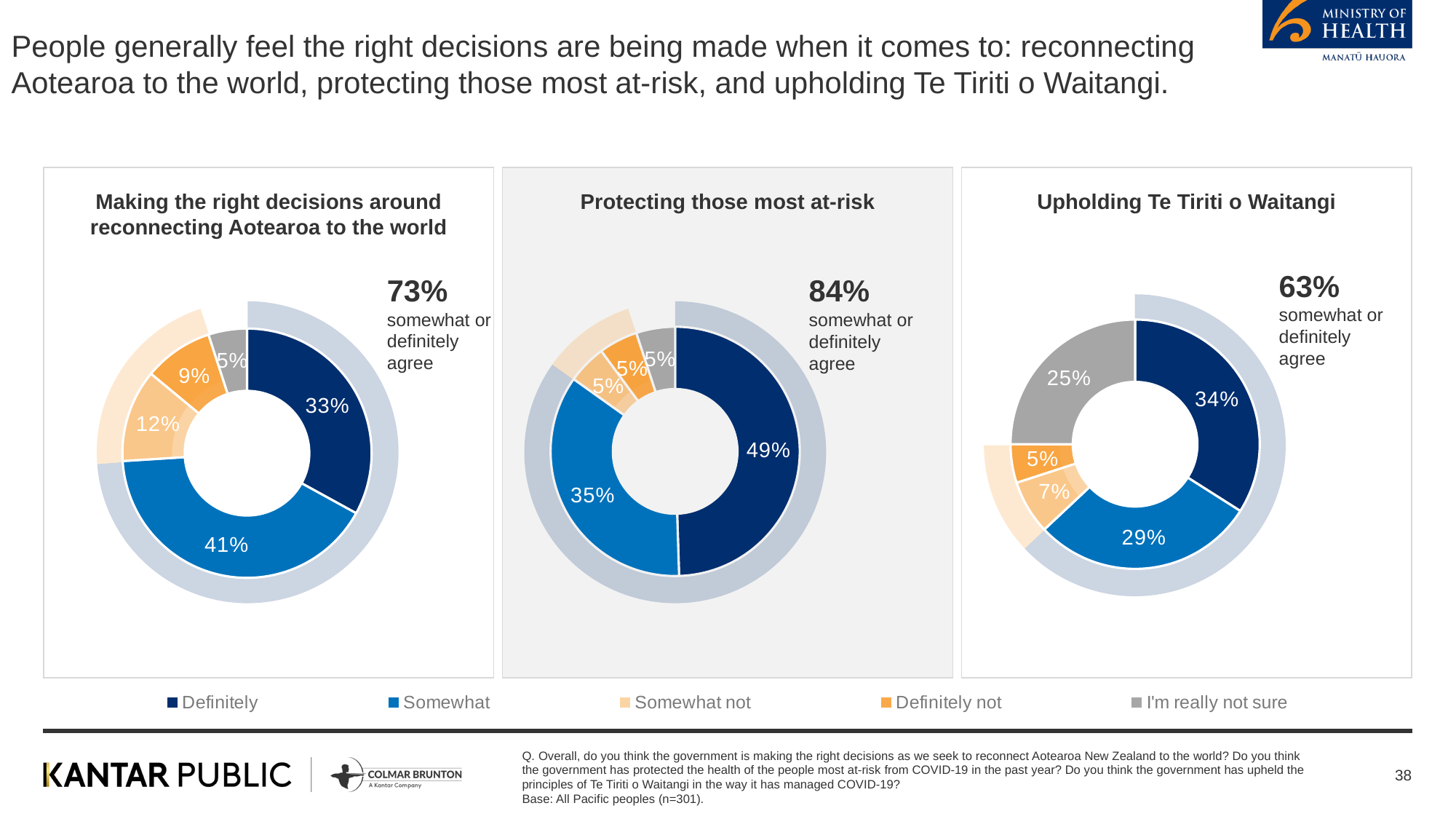
What kind of chart is used on this slide? Donut (pie) chart In the 'Making the right decisions around reconnecting Aotearoa to the world' chart, what percentage answered 'Definitely not'? 9% In the 'Making the right decisions around reconnecting Aotearoa to the world' chart, which is larger: 'Somewhat not' or 'Definitely not'? Somewhat not Which of the three charts has the highest 'somewhat or definitely agree' percentage? Protecting those most at-risk In the 'Protecting those most at-risk' chart, what percentage answered 'Definitely'? 49% In the 'Upholding Te Tiriti o Waitangi' chart, which response category has the smallest share? Definitely not In the 'Making the right decisions around reconnecting Aotearoa to the world' chart, what percentage answered 'Somewhat'? 41% In the 'Protecting those most at-risk' chart, what is the difference between the 'Definitely' and 'Somewhat' shares? 14 percentage points In the 'Upholding Te Tiriti o Waitangi' chart, what percentage somewhat or definitely agree? 63% In the 'Protecting those most at-risk' chart, which response category has the largest share? Definitely How many response categories does the legend list? 5 In the 'Upholding Te Tiriti o Waitangi' chart, what percentage answered 'I'm really not sure'? 25%